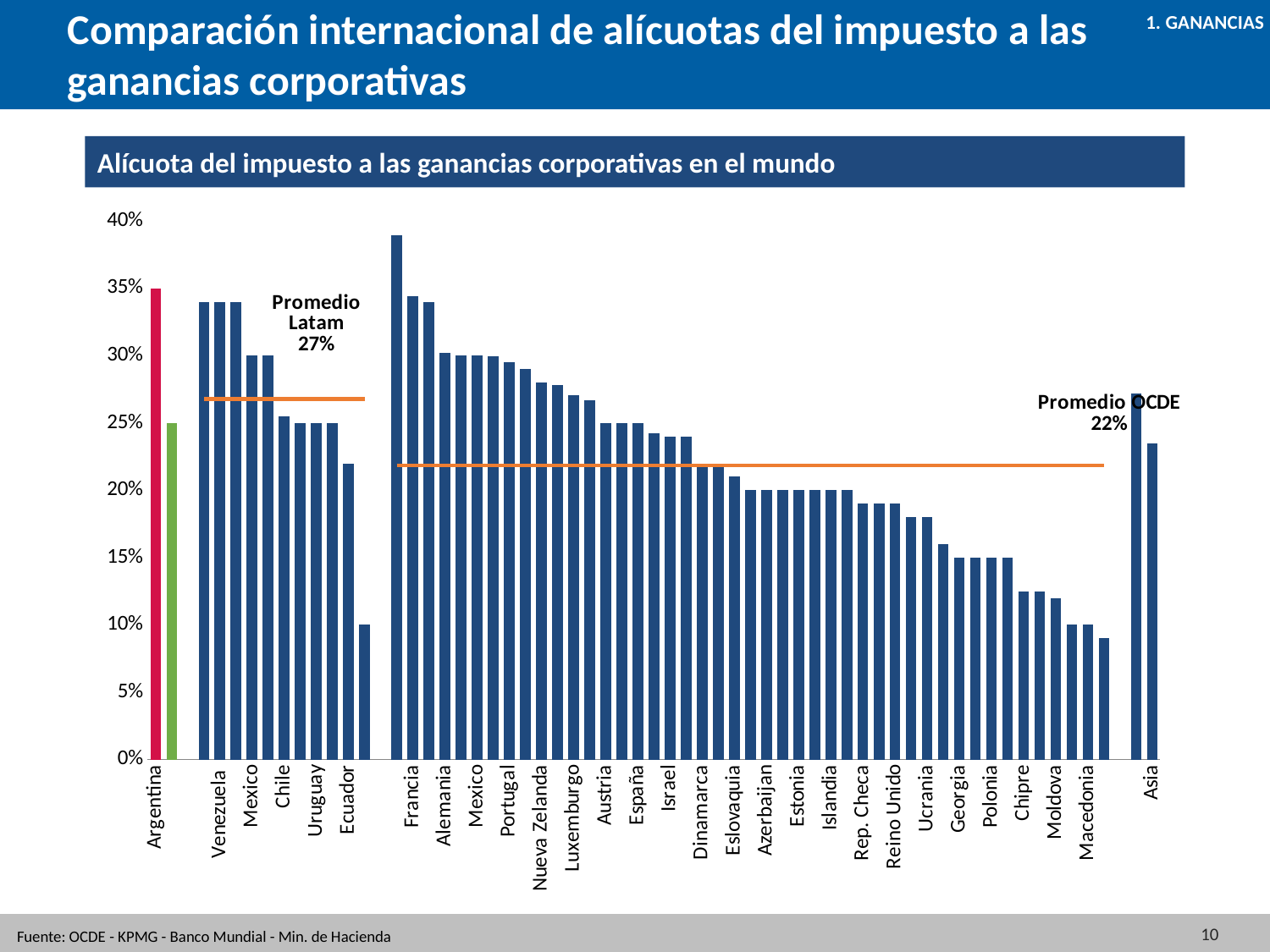
What is the difference between Promedio Latam and Promedio OCDE? 5% What is the value shown for Promedio OCDE? 22% Is the value for Ucrania greater or less than 20%? less What kind of chart is shown on the slide? bar chart What is the value shown for Promedio Latam? 27% Is the value for Venezuela greater or less than 30%? greater Which is larger, Promedio Latam or Promedio OCDE? Promedio Latam Is the value for Chipre greater or less than 15%? less What is the title of the chart? Alícuota del impuesto a las ganancias corporativas en el mundo